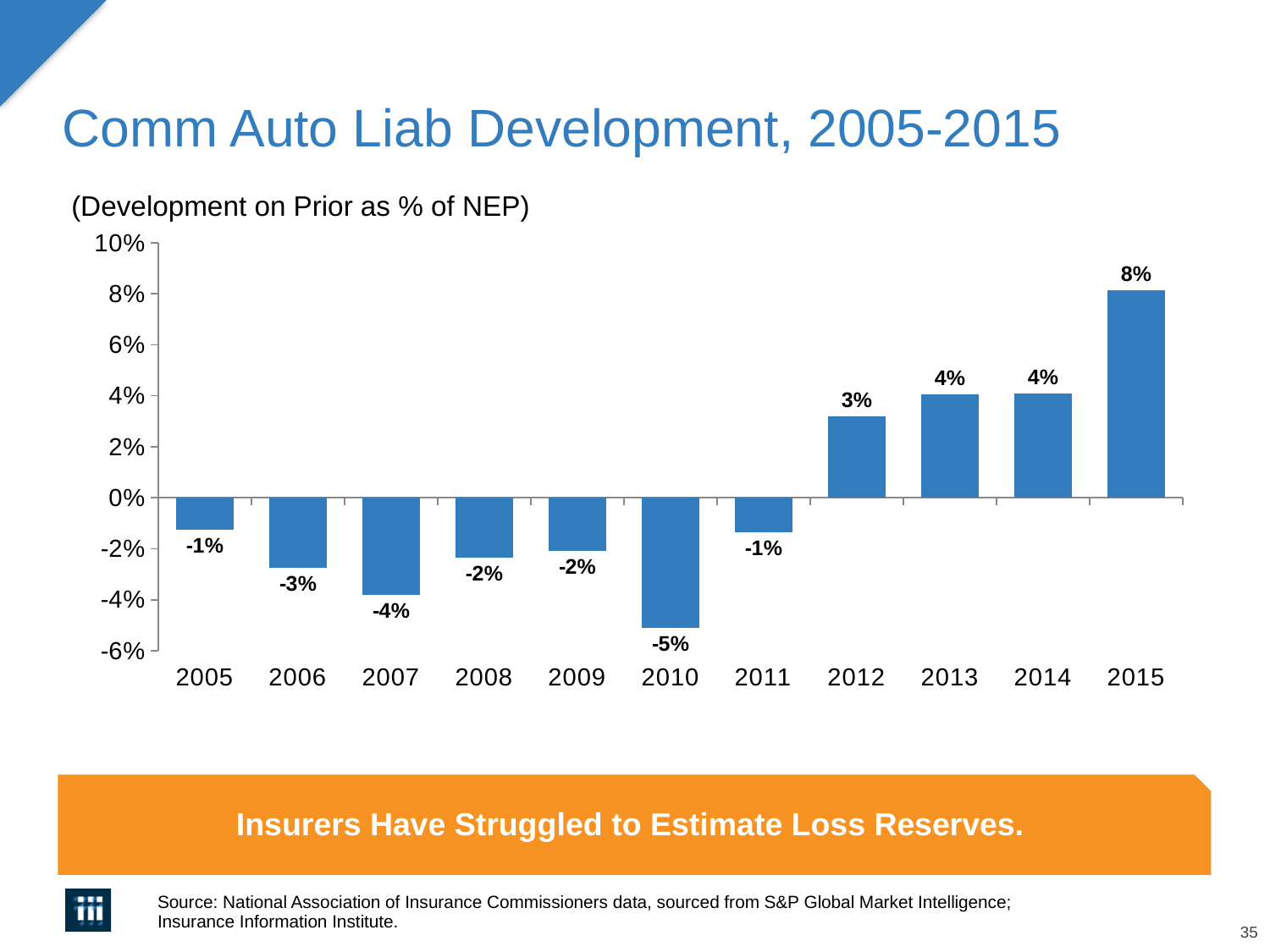
Which is larger, the value for 2012 or the value for 2013? 2013 What is the value for 2010? -5% Is the value for 2015 greater or less than 6%? greater What is the difference between the values for 2015 and 2010? 13 percentage points What kind of chart is shown on the slide? bar chart Which year has the lowest value? 2010 What is the value for 2012? 3% Which year has the highest value? 2015 What is the value for 2015? 8% Do the values rise or fall from 2011 to 2015? rise What is the value for 2007? -4% How many years are shown on the x axis? 11